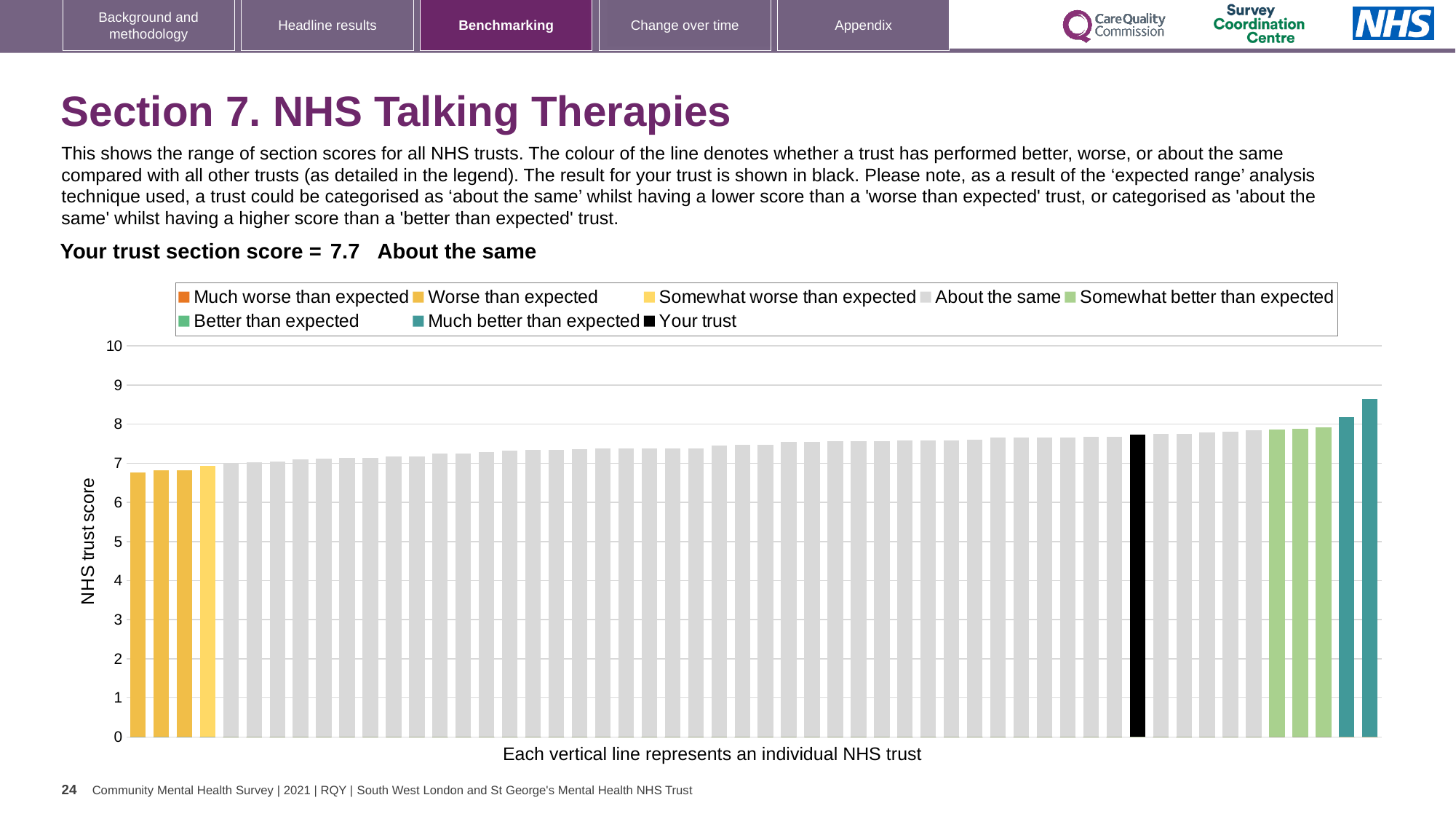
Is the value of the tallest bar in the chart greater or less than 8? greater What kind of chart is shown on the slide? bar chart Is the value of the black 'Your trust' bar greater or less than 7? greater Which legend category do the two tallest bars on the right belong to? Much better than expected What is the section score for your trust shown on the slide? 7.7 How many entries does the chart legend list? 8 Is the value of the shortest bar in the chart greater or less than 7? less Which legend category do the shortest bars on the left belong to? Worse than expected Do the bar values rise or fall from left to right along the x axis? rise Which category is your trust placed in for this section? About the same How many bars are coloured as 'Much better than expected'? 2 What is the label on the vertical axis of the chart? NHS trust score